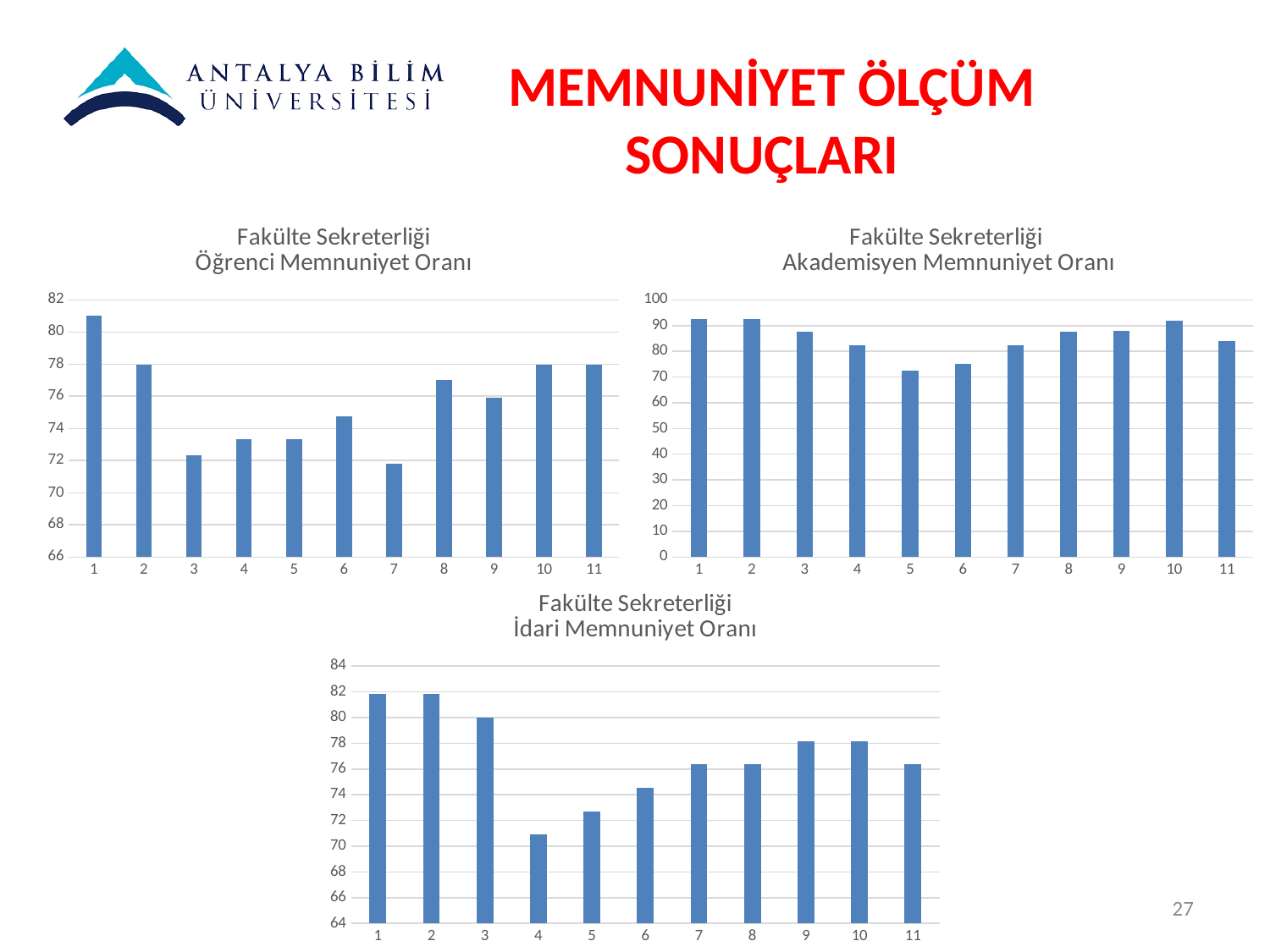
In the 'Fakülte Sekreterliği Akademisyen Memnuniyet Oranı' chart, which is larger, the value for category 6 or the value for category 9? category 9 In the 'Fakülte Sekreterliği Akademisyen Memnuniyet Oranı' chart, is the value for category 5 greater or less than 80? less How many charts are shown on the slide? 3 How many categories are shown on the x axis of the 'Fakülte Sekreterliği Akademisyen Memnuniyet Oranı' chart? 11 What kind of chart is the 'Fakülte Sekreterliği Öğrenci Memnuniyet Oranı' chart? bar chart In the 'Fakülte Sekreterliği Akademisyen Memnuniyet Oranı' chart, which category has the lowest value? 5 In the 'Fakülte Sekreterliği İdari Memnuniyet Oranı' chart, which category has the lowest value? 4 In the 'Fakülte Sekreterliği İdari Memnuniyet Oranı' chart, is the value for category 4 greater or less than 72? less In the 'Fakülte Sekreterliği Öğrenci Memnuniyet Oranı' chart, which category has the highest value? 1 In the 'Fakülte Sekreterliği Öğrenci Memnuniyet Oranı' chart, which category has the lowest value? 7 In the 'Fakülte Sekreterliği İdari Memnuniyet Oranı' chart, which is larger, the value for category 3 or the value for category 5? category 3 In the 'Fakülte Sekreterliği Öğrenci Memnuniyet Oranı' chart, is the value for category 1 greater or less than 80? greater